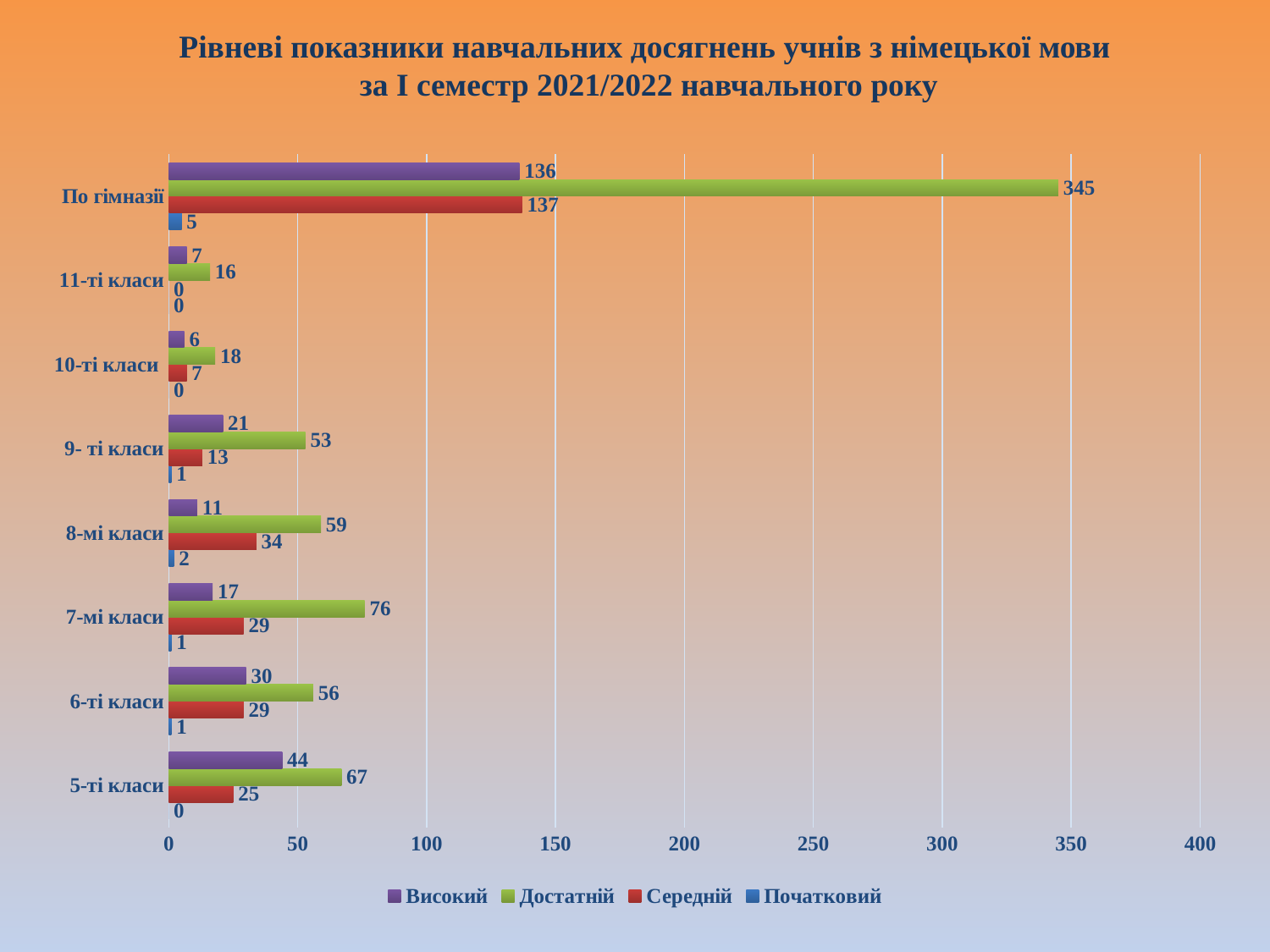
What is the value of Високий for 5-ті класи? 44 What is the value of Достатній for По гімназії? 345 Among the class groups (excluding По гімназії), which category has the lowest Високий value? 10-ті класи Which is larger for 7-мі класи: the Високий value or the Середній value? Середній Among the class groups (excluding По гімназії), which category has the highest Достатній value? 7-мі класи How many categories are shown on the y axis? 8 What is the total of the four values for 10-ті класи? 31 How many series does the legend list? 4 What is the difference between the Достатній and Високий values for 6-ті класи? 26 What is the value of Початковий for 9- ті класи? 1 What is the value of Середній for 8-мі класи? 34 What kind of chart is shown on the slide? bar chart